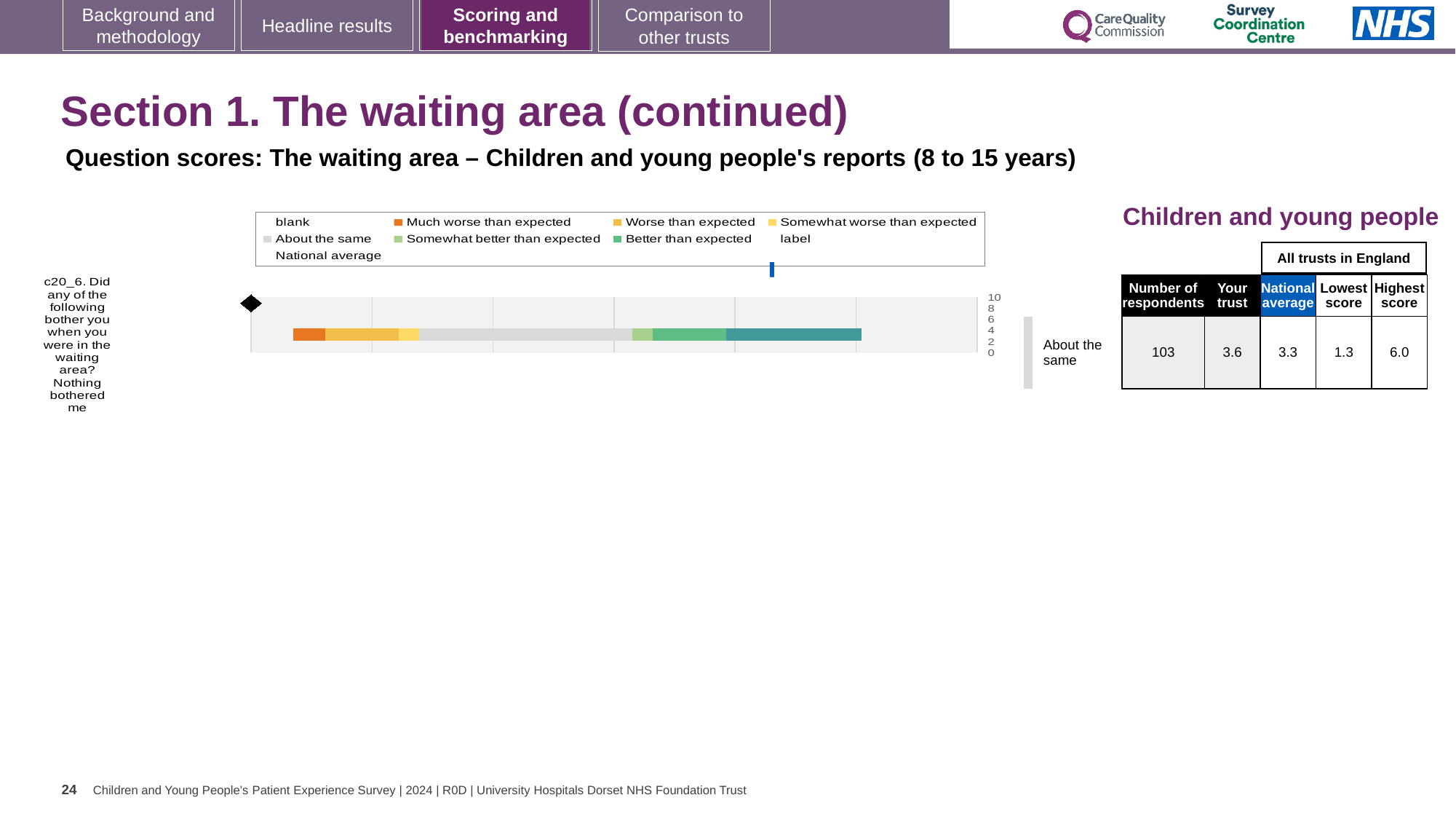
What kind of chart is shown on the slide? Stacked horizontal bar chart Is the 'Your trust' score for c20_6 larger or smaller than the national average? Larger What is the difference between the highest score and the lowest score for c20_6 in the table? 4.7 In the table, what is the 'Your trust' score for c20_6? 3.6 In the table, what is the highest score across all trusts in England for c20_6? 6.0 In the table, what is the national average score for c20_6? 3.3 How many question categories are plotted in the chart? 1 Which question is plotted in the chart? c20_6. Did any of the following bother you when you were in the waiting area? Nothing bothered me What colour represents 'Much worse than expected' in the chart legend? Orange In the table, what is the lowest score across all trusts in England for c20_6? 1.3 In the table, what is the number of respondents for c20_6? 103 According to the label next to the bar, how does the trust's score for c20_6 compare to expectation? About the same